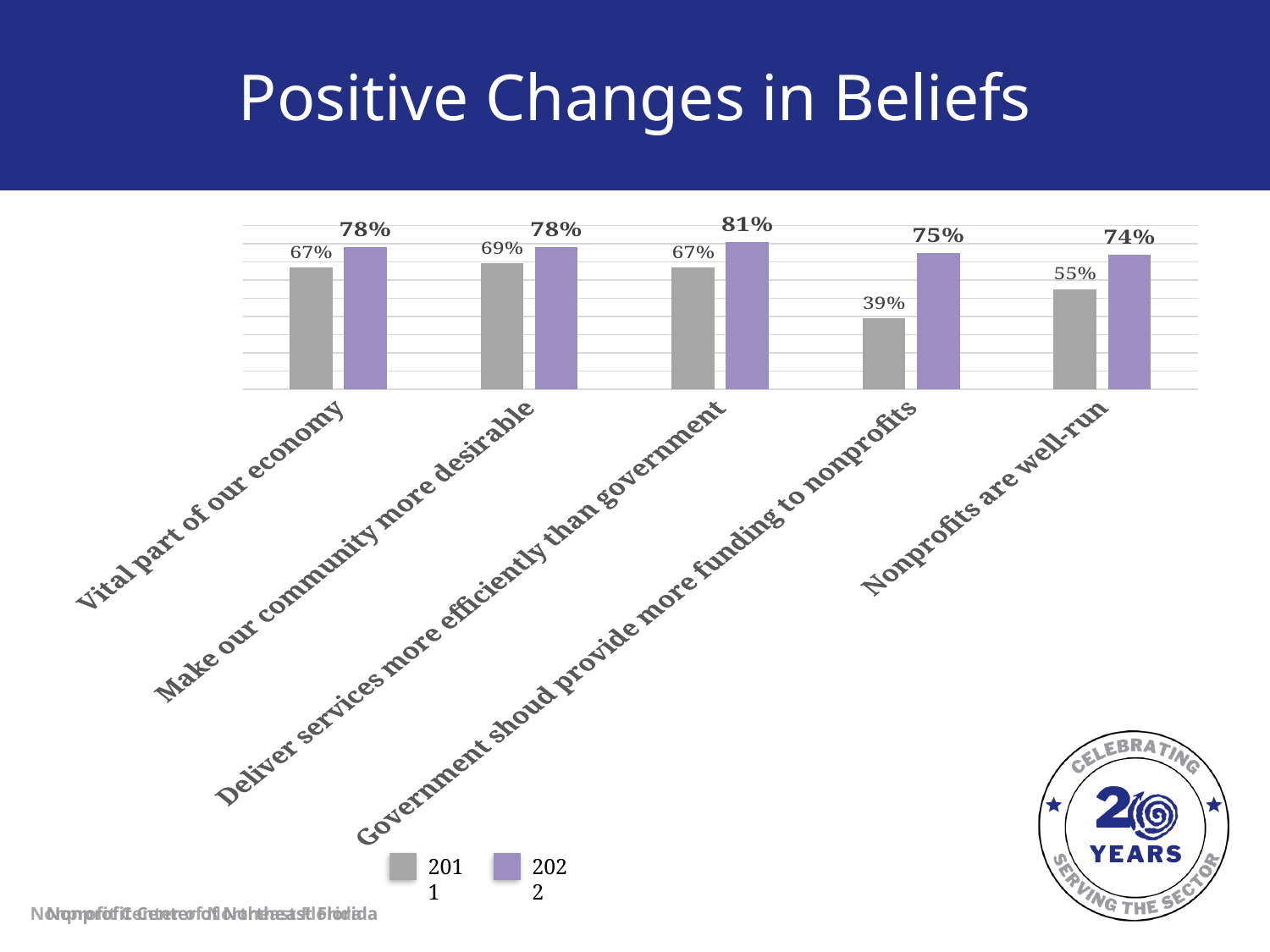
What is the 2011 value for "Nonprofits are well-run"? 55% What is the difference between the 2022 and 2011 values for "Government shoud provide more funding to nonprofits"? 36% What is the 2011 value for "Government shoud provide more funding to nonprofits"? 39% Which is larger: the 2011 value for "Make our community more desirable" or the 2011 value for "Nonprofits are well-run"? Make our community more desirable How many series does the legend list? 2 Which category has the highest 2022 value? Deliver services more efficiently than government What is the 2022 value for "Deliver services more efficiently than government"? 81% What is the 2022 value for "Make our community more desirable"? 78% How many categories are shown on the x axis? 5 What is the difference between the 2022 and 2011 values for "Vital part of our economy"? 11% Which category has the lowest 2011 value? Government shoud provide more funding to nonprofits What kind of chart is shown on the slide? Bar chart